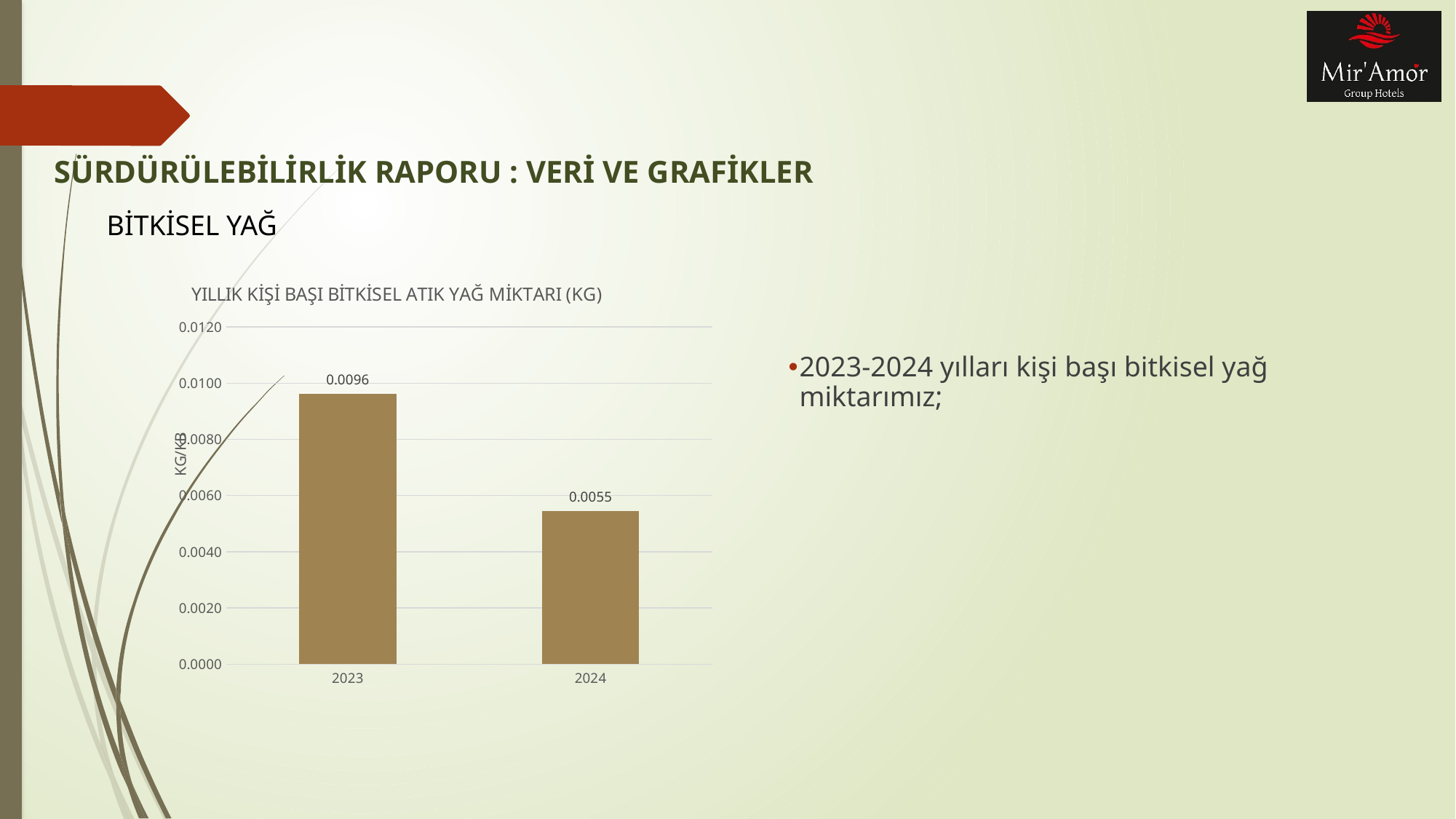
Which year has the highest value? 2023 Which year has the lowest value? 2024 Is the value for 2024 greater or less than 0.0060? less What is the value for 2024? 0.0055 What kind of chart is shown? bar chart What is the value for 2023? 0.0096 Do the values rise or fall from 2023 to 2024? fall What is the title of the chart? YILLIK KİŞİ BAŞI BİTKİSEL ATIK YAĞ MİKTARI (KG) What is the difference between the values for 2023 and 2024? 0.0041 How many years are shown on the chart? 2 Is the value for 2023 greater or less than 0.0080? greater Which is larger, the value for 2023 or the value for 2024? 2023